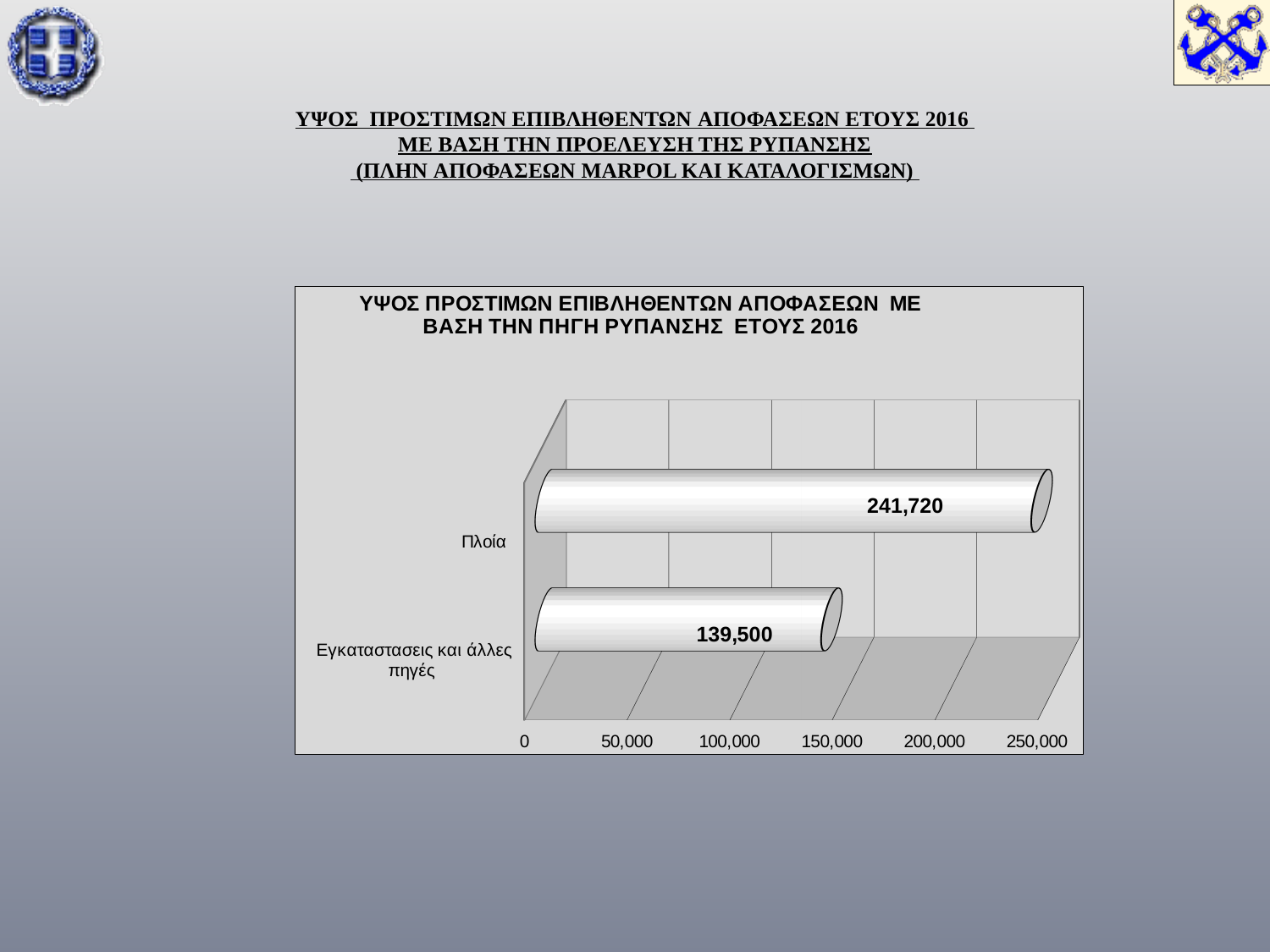
What is the title of the chart? ΥΨΟΣ ΠΡΟΣΤΙΜΩΝ ΕΠΙΒΛΗΘΕΝΤΩΝ ΑΠΟΦΑΣΕΩΝ ΜΕ ΒΑΣΗ ΤΗΝ ΠΗΓΗ ΡΥΠΑΝΣΗΣ ΕΤΟΥΣ 2016 Which category has the highest value? Πλοία How many categories are shown in the chart? 2 What is the value for Εγκαταστασεις και άλλες πηγές? 139,500 What kind of chart is shown on the slide? bar chart What is the difference between the values for Πλοία and Εγκαταστασεις και άλλες πηγές? 102,220 Is the value for Πλοία greater or less than 200,000? greater Which is larger, the value for Πλοία or the value for Εγκαταστασεις και άλλες πηγές? Πλοία What is the value for Πλοία? 241,720 Which category has the lowest value? Εγκαταστασεις και άλλες πηγές What is the maximum value shown on the horizontal axis? 250,000 Is the value for Εγκαταστασεις και άλλες πηγές greater or less than 150,000? less